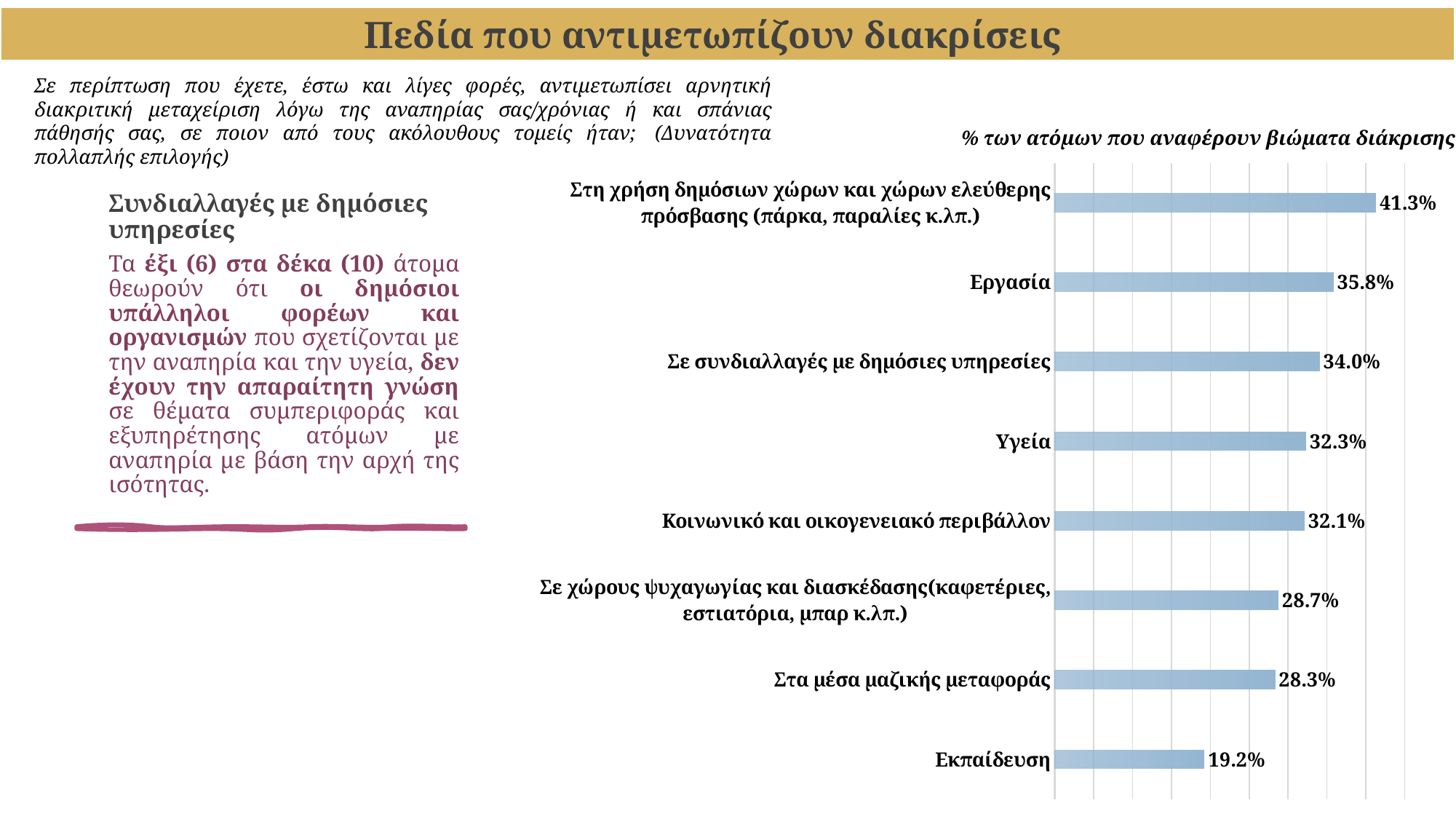
What value is shown for Εργασία? 35.8% What percentage is shown for Εκπαίδευση? 19.2% Which is larger, the value for Εργασία or the value for Υγεία? Εργασία What kind of chart is shown on the slide? Bar chart Which category has the lowest value? Εκπαίδευση What is the difference between the values for Εργασία and Εκπαίδευση? 16.6% What value is shown for Στα μέσα μαζικής μεταφοράς? 28.3% What is the title of the chart? % των ατόμων που αναφέρουν βιώματα διάκρισης How many categories are shown in the chart? 8 Which category has the highest value? Στη χρήση δημόσιων χώρων και χώρων ελεύθερης πρόσβασης (πάρκα, παραλίες κ.λπ.) What value is shown for Υγεία? 32.3% What is the difference between the values for Σε συνδιαλλαγές με δημόσιες υπηρεσίες and Στα μέσα μαζικής μεταφοράς? 5.7%